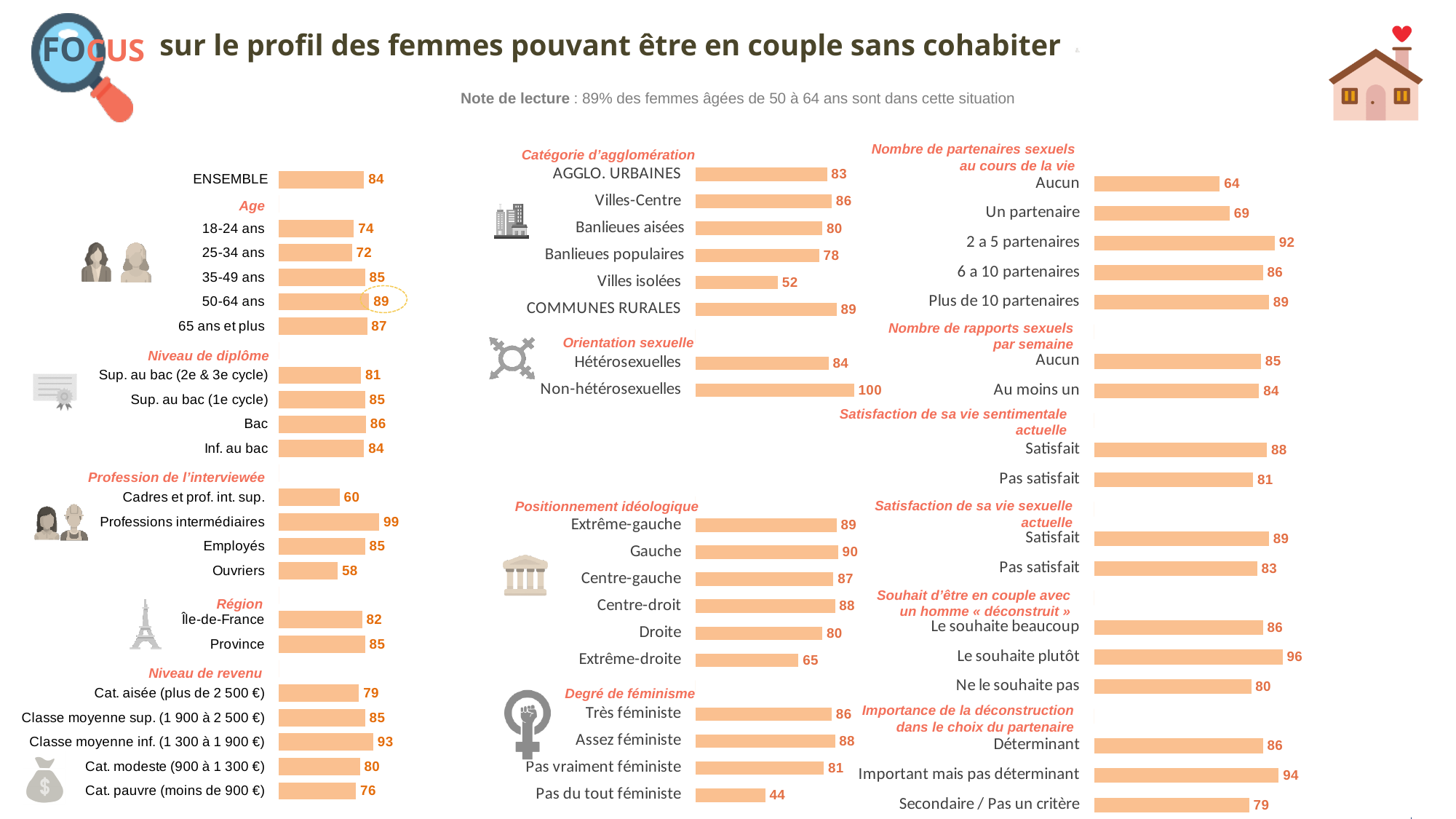
In the Profession de l'interviewée section, which category has the lowest value? Ouvriers In the Importance de la déconstruction dans le choix du partenaire chart, what is the difference between Important mais pas déterminant and Secondaire / Pas un critère? 15 In the left-hand chart, what is the value for ENSEMBLE? 84 How many categories are shown in the Niveau de revenu section of the left-hand chart? 5 In the Orientation sexuelle chart, what is the difference between Non-hétérosexuelles and Hétérosexuelles? 16 In the Souhait d'être en couple avec un homme « déconstruit » chart, what is the value for Le souhaite plutôt? 96 In the Nombre de partenaires sexuels au cours de la vie chart, which category has the highest value? 2 a 5 partenaires In the Catégorie d'agglomération chart, what is the value for Villes isolées? 52 In the Degré de féminisme chart, what is the value for Pas du tout féministe? 44 In the Age section of the left-hand chart, which age group has the highest value? 50-64 ans What type of chart is used throughout this slide? Bar chart In the Positionnement idéologique chart, which is larger: Gauche or Extrême-droite? Gauche